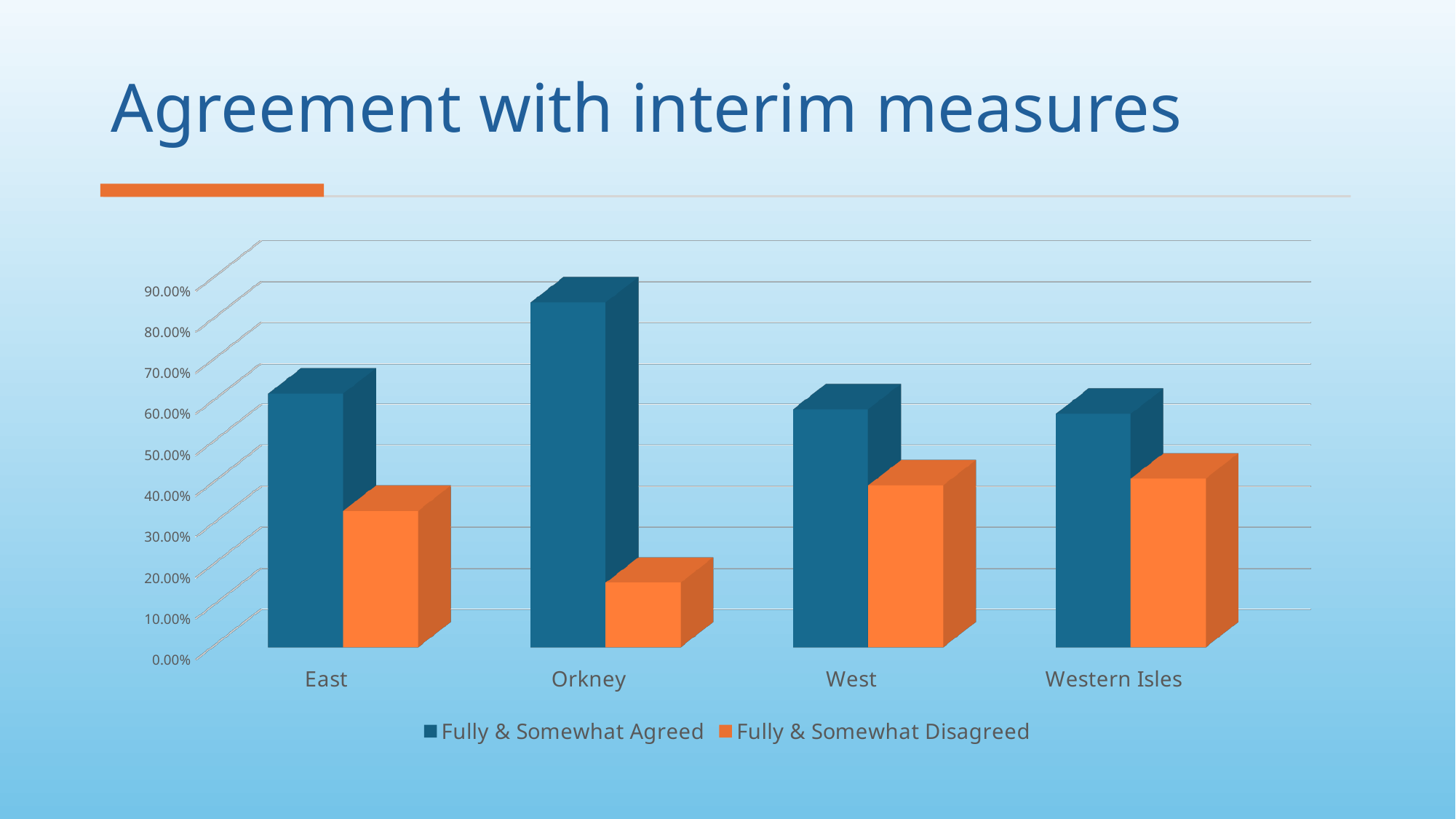
Which category has the highest value for Fully & Somewhat Agreed? Orkney Is the Fully & Somewhat Agreed value for Orkney greater or less than 70.00%? greater What is the title of the slide containing the chart? Agreement with interim measures What kind of chart is shown on the slide? bar chart Is the Fully & Somewhat Agreed value for West greater or less than 50.00%? greater How many series does the chart legend list? 2 For East, which is larger: Fully & Somewhat Agreed or Fully & Somewhat Disagreed? Fully & Somewhat Agreed Is the Fully & Somewhat Disagreed value for Western Isles greater or less than 50.00%? less How many categories are shown on the x axis of the chart? 4 Which is larger: Fully & Somewhat Agreed for Orkney or Fully & Somewhat Agreed for East? Orkney Which category has the lowest value for Fully & Somewhat Disagreed? Orkney